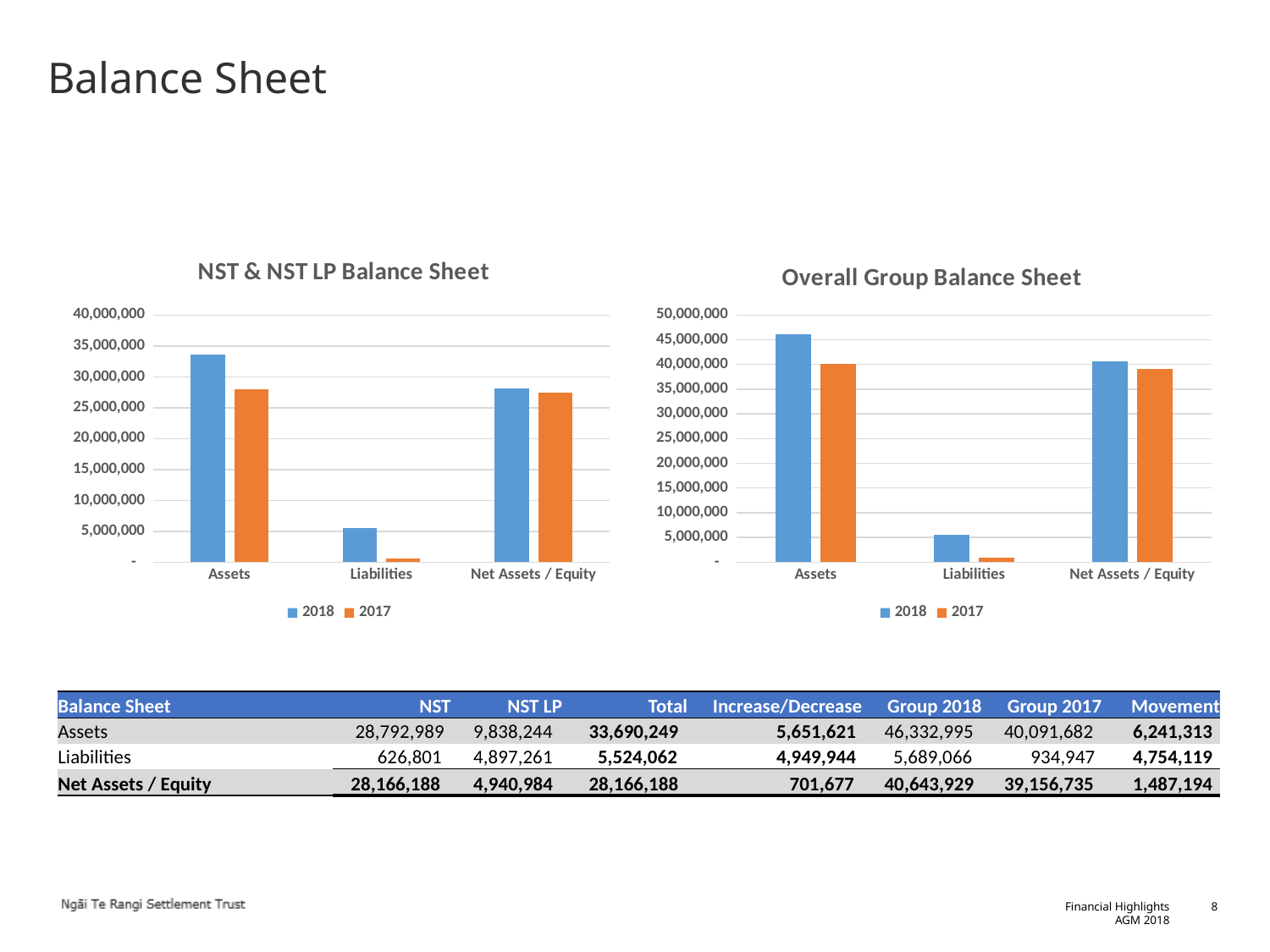
On the Overall Group Balance Sheet chart, how many categories are shown on the x axis? 3 On the NST & NST LP Balance Sheet chart, is the 2017 value for Liabilities greater or less than 5,000,000? less On the NST & NST LP Balance Sheet chart, what colour are the 2017 bars? orange On the NST & NST LP Balance Sheet chart, what kind of chart is used? bar chart On the Overall Group Balance Sheet chart, is the 2018 value for Assets greater or less than 45,000,000? greater On the Overall Group Balance Sheet chart, which category has the lowest 2017 value? Liabilities On the NST & NST LP Balance Sheet chart, how many series does the legend list? 2 On the NST & NST LP Balance Sheet chart, is the 2018 value for Assets greater or less than 30,000,000? greater On the NST & NST LP Balance Sheet chart, which category has the highest 2018 value? Assets On the NST & NST LP Balance Sheet chart, which year has the larger value for Assets, 2018 or 2017? 2018 On the Overall Group Balance Sheet chart, what are the two legend entries? 2018 and 2017